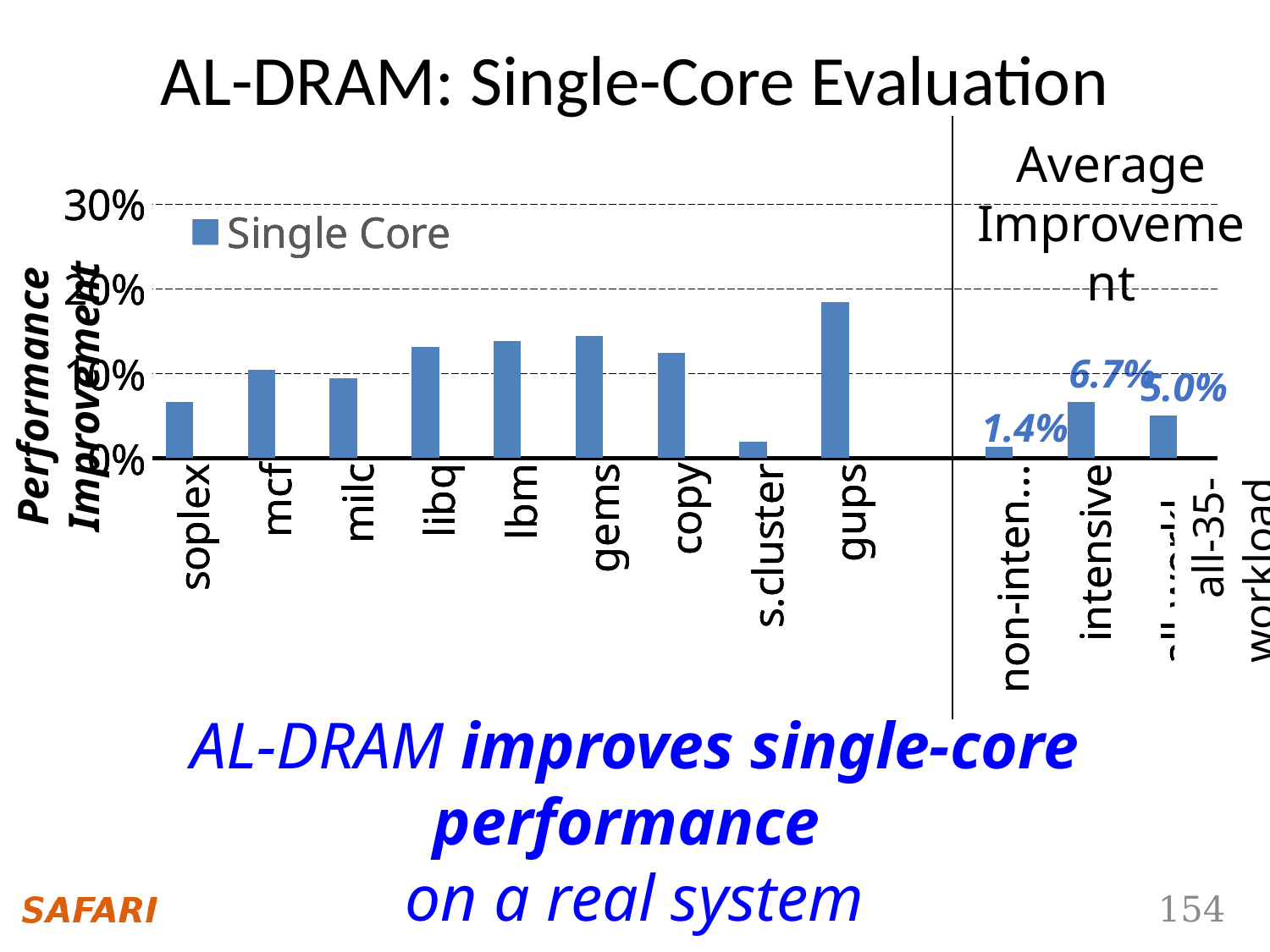
What is the average performance improvement shown for the intensive workloads? 6.7% What kind of chart is shown on the slide? bar chart Which has a larger performance improvement, gups or lbm? gups Which individual benchmark (left of the divider) has the highest performance improvement? gups How many series does the legend list? 1 Is the performance improvement for gups greater or less than 10%? greater What is the average performance improvement shown for the non-intensive workloads? 1.4% What is the difference between the average improvement for intensive workloads and for non-intensive workloads? 5.3% What is the average performance improvement shown for all 35 workloads? 5.0% Is the performance improvement for soplex greater or less than 10%? less What is the name of the series shown in the legend? Single Core Which individual benchmark (left of the divider) has the lowest performance improvement? s.cluster